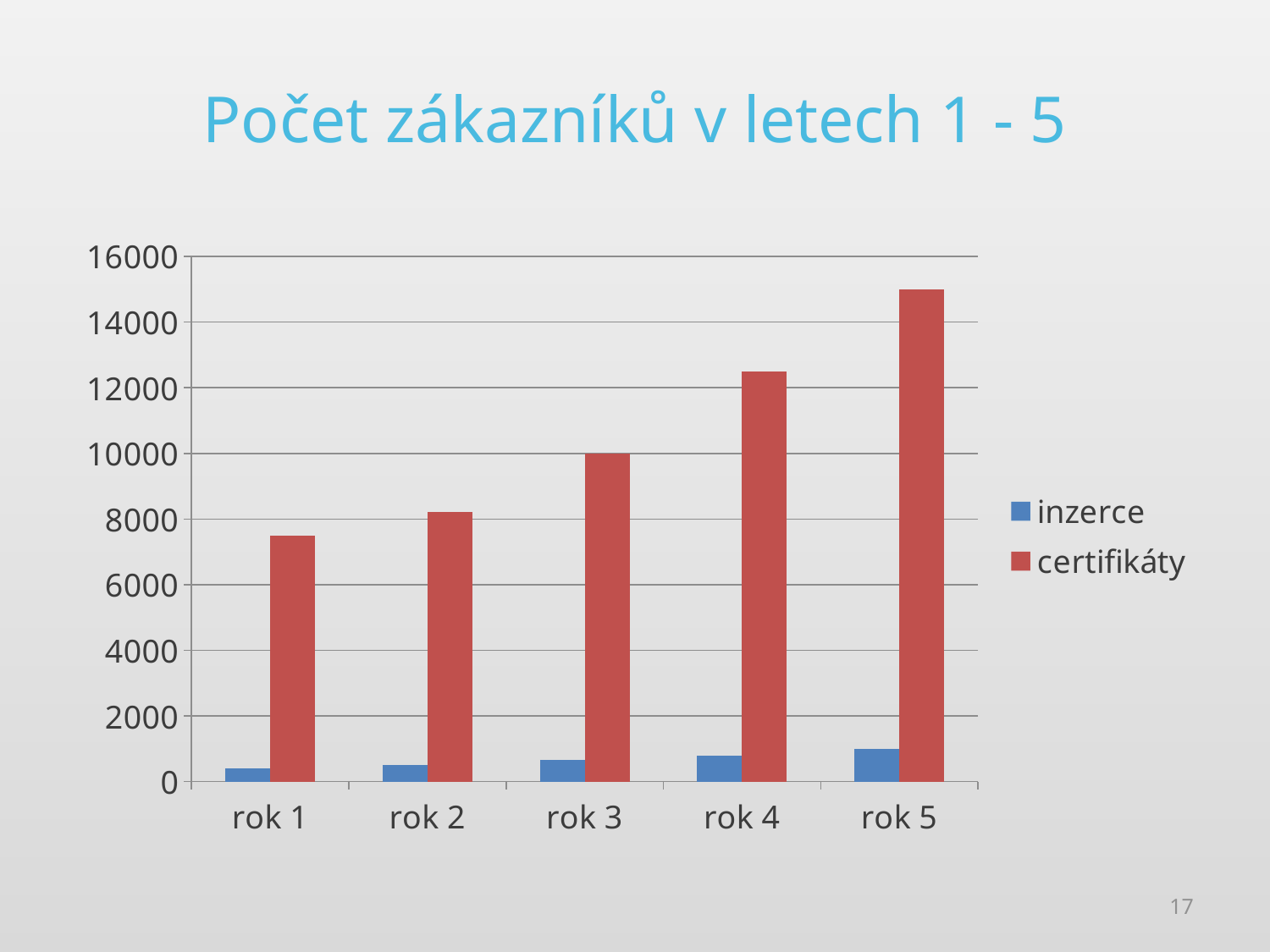
How many categories are shown on the x axis? 5 Is the certifikáty value for rok 5 greater or less than 14000? greater What type of chart is shown on the slide? bar chart What is the title of the chart? Počet zákazníků v letech 1 - 5 In which year is the certifikáty value highest? rok 5 Is the certifikáty value for rok 1 greater or less than 8000? less For rok 4, which series has the larger value, inzerce or certifikáty? certifikáty What is the value of certifikáty for rok 3? 10000 In which year is the certifikáty value lowest? rok 1 Do the certifikáty values rise or fall from rok 1 to rok 5? rise How many series does the legend list? 2 Is the inzerce value for rok 5 greater or less than 2000? less